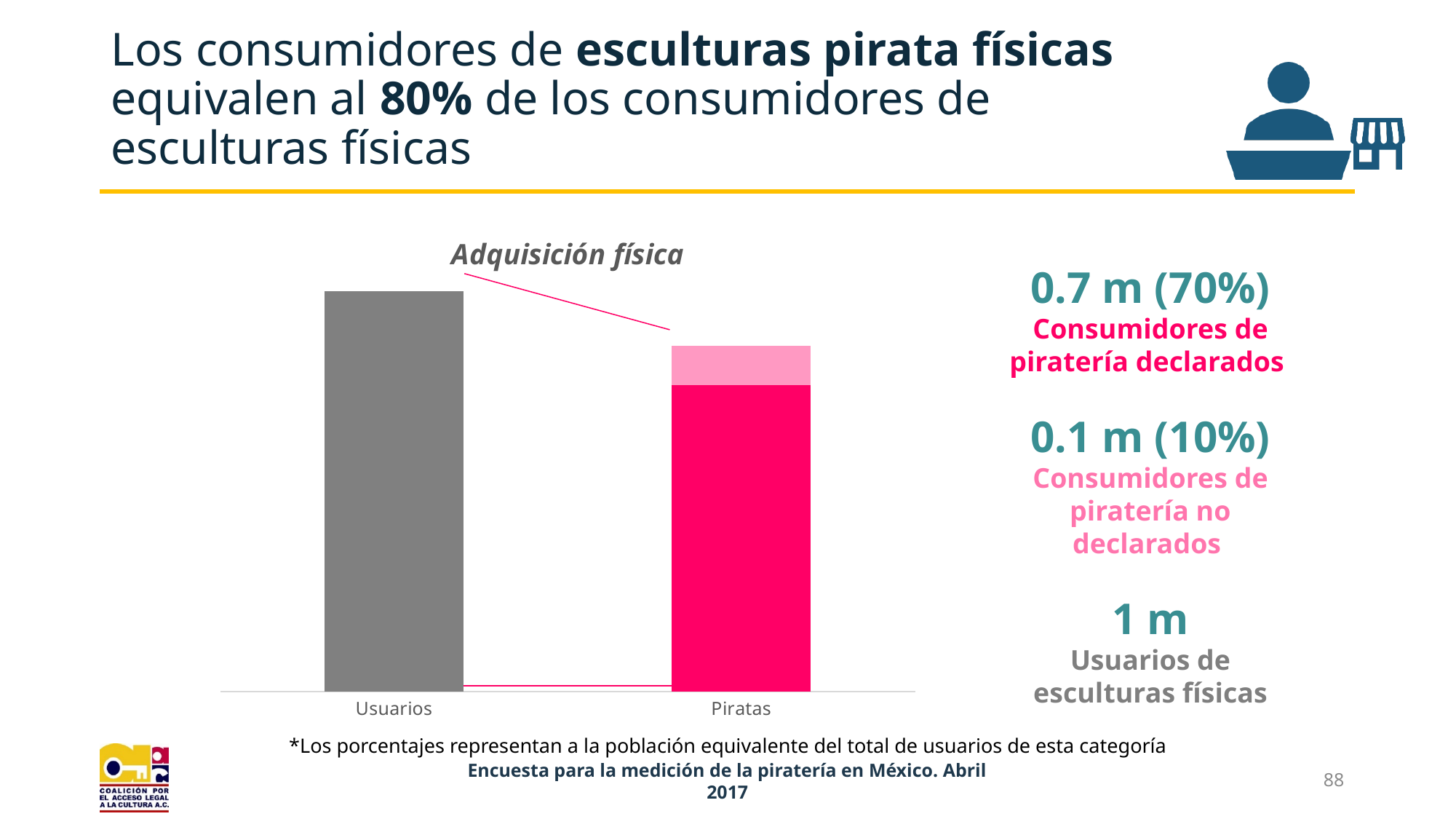
Which category has the taller bar, Usuarios or Piratas? Usuarios What is the value for Consumidores de piratería declarados? 0.7 m (70%) What colour is the Usuarios bar? gray What is the value for Usuarios de esculturas físicas? 1 m Which category has the lowest bar? Piratas How many categories are shown on the x axis of the chart? 2 Which segment of the Piratas bar is larger, declarados or no declarados? declarados What is the difference between Consumidores de piratería declarados and Consumidores de piratería no declarados? 0.6 m What is the value for Consumidores de piratería no declarados? 0.1 m (10%) What kind of chart is shown on the slide? bar chart What is the total of the stacked Piratas bar (declarados plus no declarados)? 0.8 m What is the title of the chart? Adquisición física